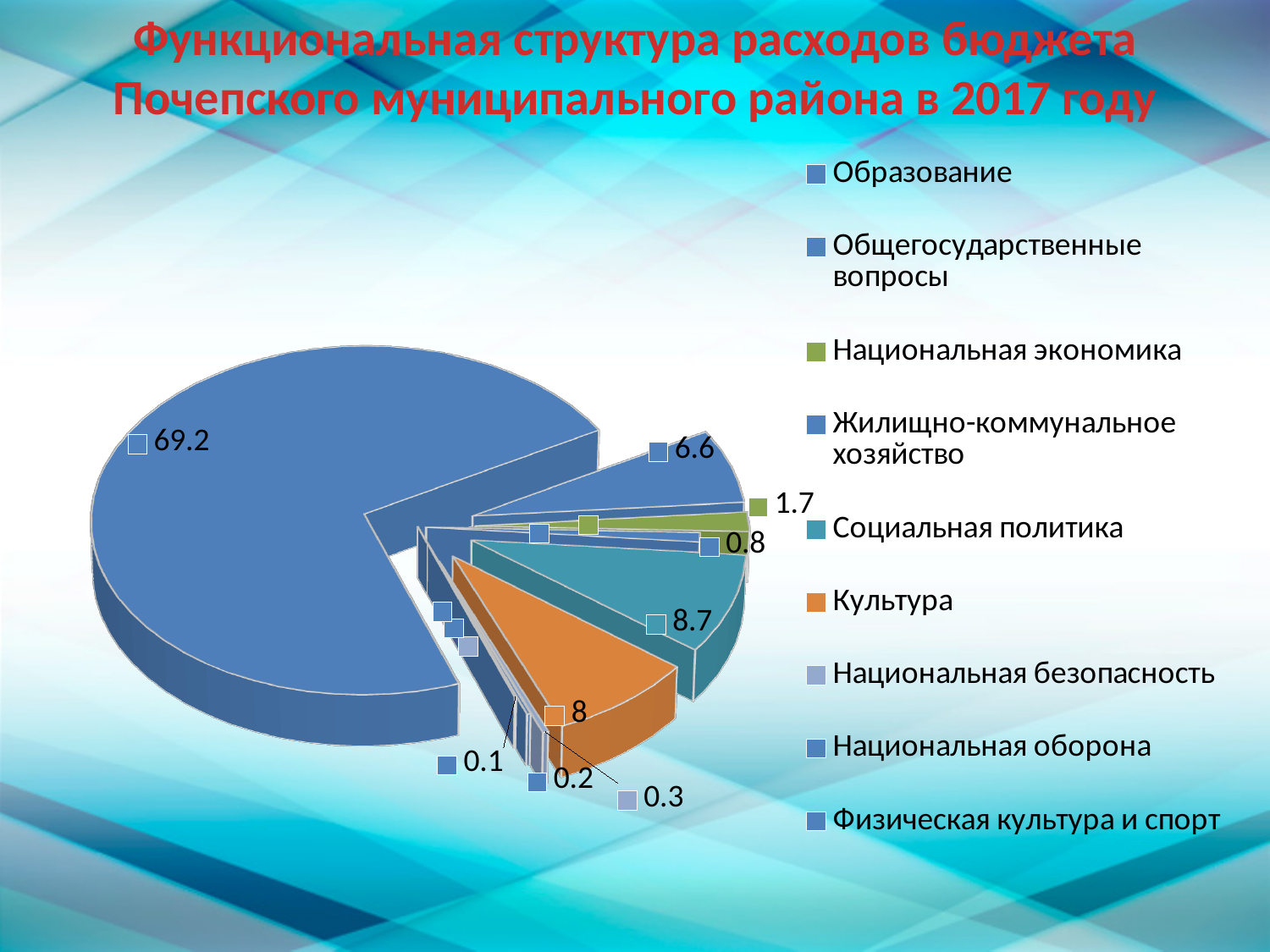
What is the value shown for Культура? 8 What is the value shown for Образование? 69.2 How many categories does the legend of the pie chart list? 9 Which is larger, the value for Социальная политика or the value for Культура? Социальная политика What is the smallest value labelled on the pie chart? 0.1 What is the difference between the values for Образование and Общегосударственные вопросы? 62.6 What is the value shown for Общегосударственные вопросы? 6.6 What kind of chart is shown on the slide? pie chart What is the value shown for Жилищно-коммунальное хозяйство? 0.8 Which category has the largest slice of the pie? Образование What is the value shown for Социальная политика? 8.7 What is the value shown for Национальная экономика? 1.7